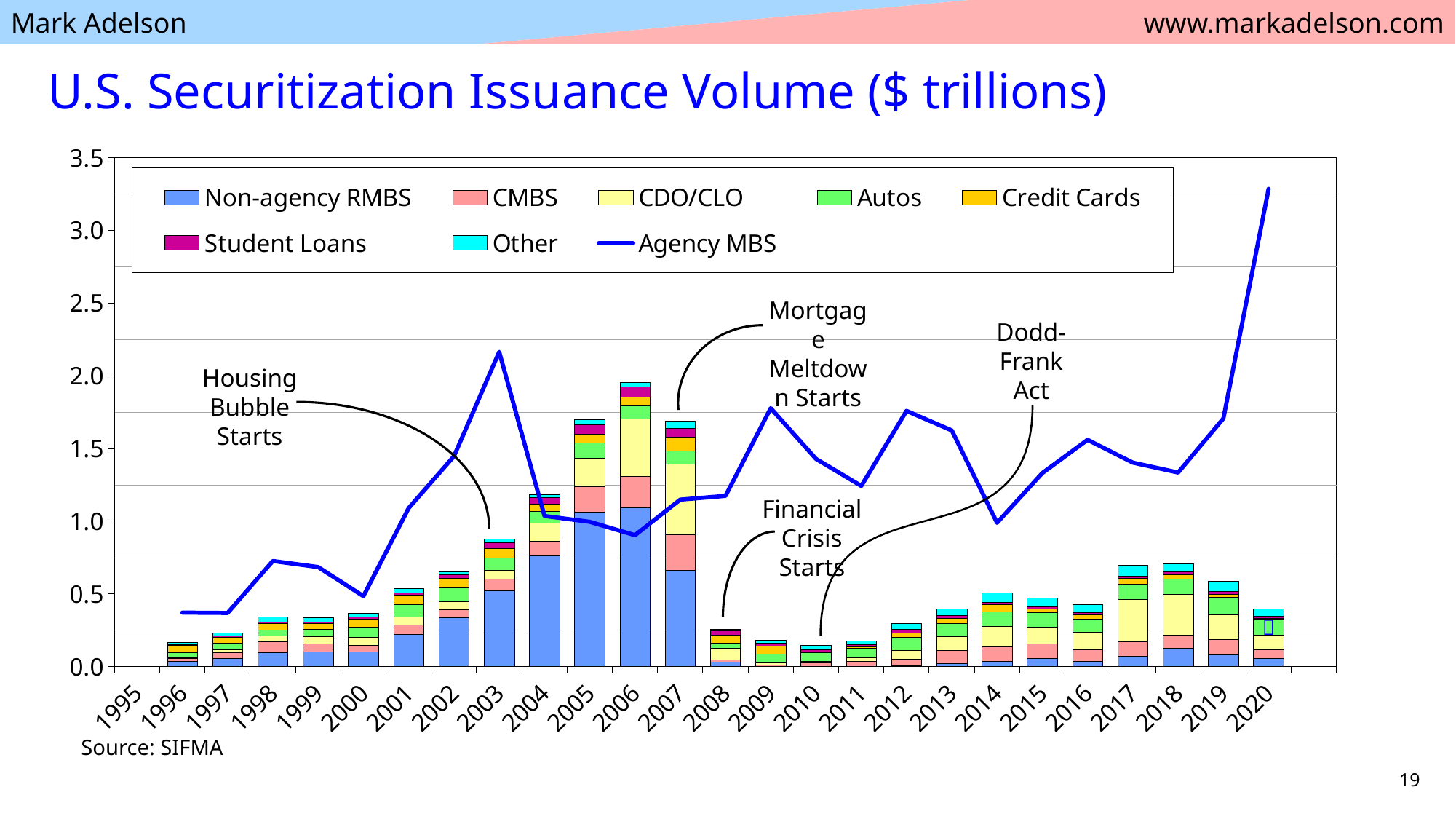
In which year does the Agency MBS line reach its highest value? 2020 Is the total of the stacked bar for 2010 greater or less than 0.5? less Is the Agency MBS value for 2003 greater or less than 2.0? greater Is the total of the stacked bar for 2005 greater or less than 1.5? greater Does the Agency MBS line rise or fall from 2017 to 2020? rise Which series is plotted as a line rather than as stacked bars? Agency MBS What kind of chart is shown on the slide? A stacked bar chart with a line series Which is larger, the Agency MBS value for 2003 or for 2004? 2003 How many series does the legend list? 8 What is the title of the chart? U.S. Securitization Issuance Volume ($ trillions) Which year has the tallest stacked bar? 2006